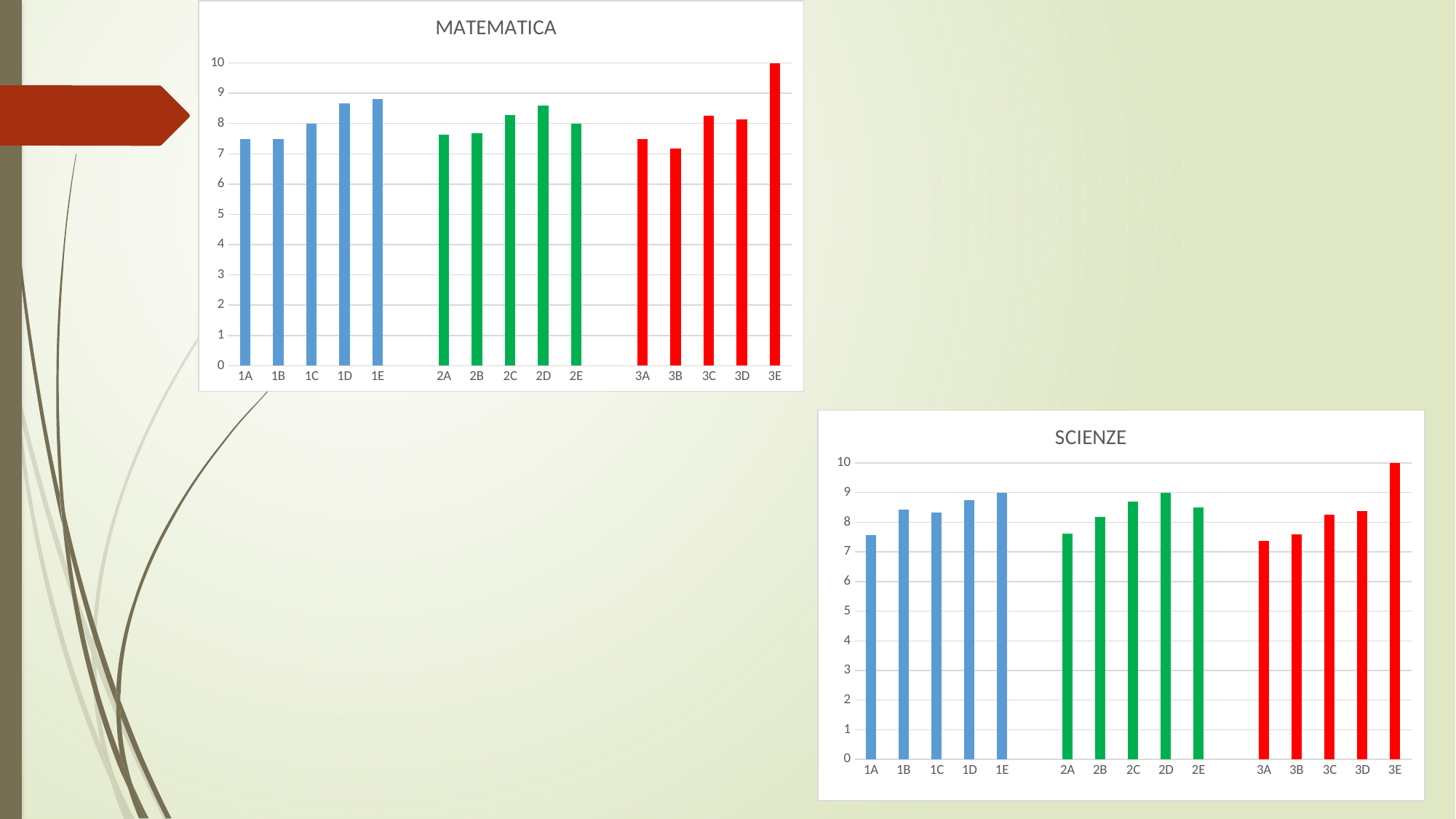
In the MATEMATICA chart, which class has the highest value? 3E In the SCIENZE chart, is the value for 1A greater or less than 8? less In the SCIENZE chart, which class has the highest value? 3E In the SCIENZE chart, which is larger, the value for 2D or the value for 2A? 2D In the MATEMATICA chart, is the value for 3B greater or less than 8? less What is the title of the chart in the lower right of the slide? SCIENZE In the SCIENZE chart, what is the value for 3E? 10 In the MATEMATICA chart, is the value for 1D greater or less than 8? greater In the MATEMATICA chart, what is the value for 3E? 10 In the MATEMATICA chart, which class has the lowest value? 3B What type of chart is the MATEMATICA chart? bar chart How many classes are shown on the x axis of the SCIENZE chart? 15